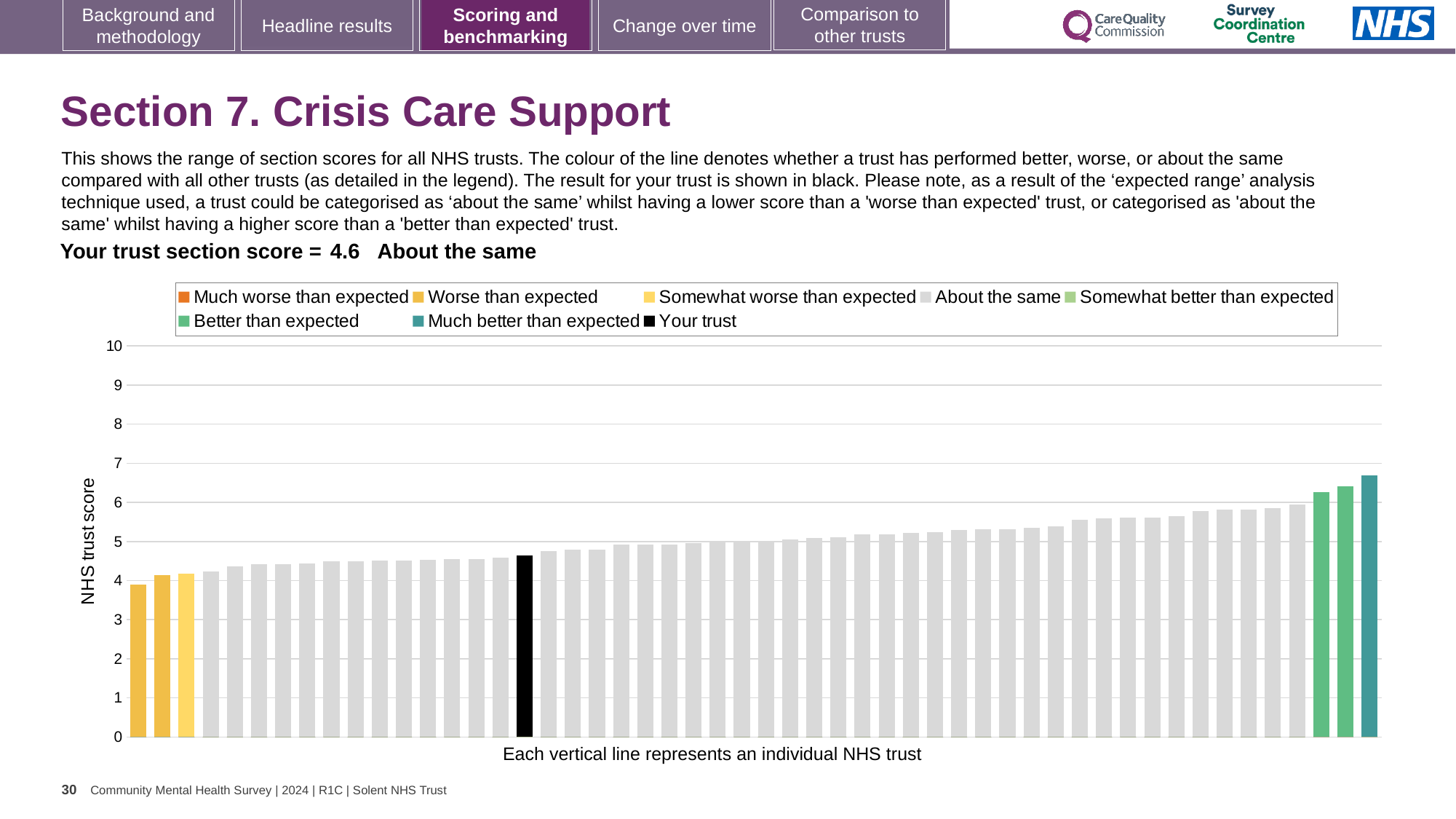
What kind of chart is shown on the slide? bar chart Do the bar values rise or fall from left to right across the chart? rise What is the label on the vertical axis of the chart? NHS trust score Which category is your trust placed in for this section? About the same How many bars are coloured as 'Much better than expected'? 1 How many entries does the chart legend list? 8 What colour is the bar representing your trust? black What is the section score for your trust shown on the slide? 4.6 Which is taller, the leftmost bar or the rightmost bar? the rightmost bar Is the value for the tallest bar greater or less than 6? greater Is the value for your trust's bar greater or less than 5? less How many bars are coloured as 'Better than expected'? 2